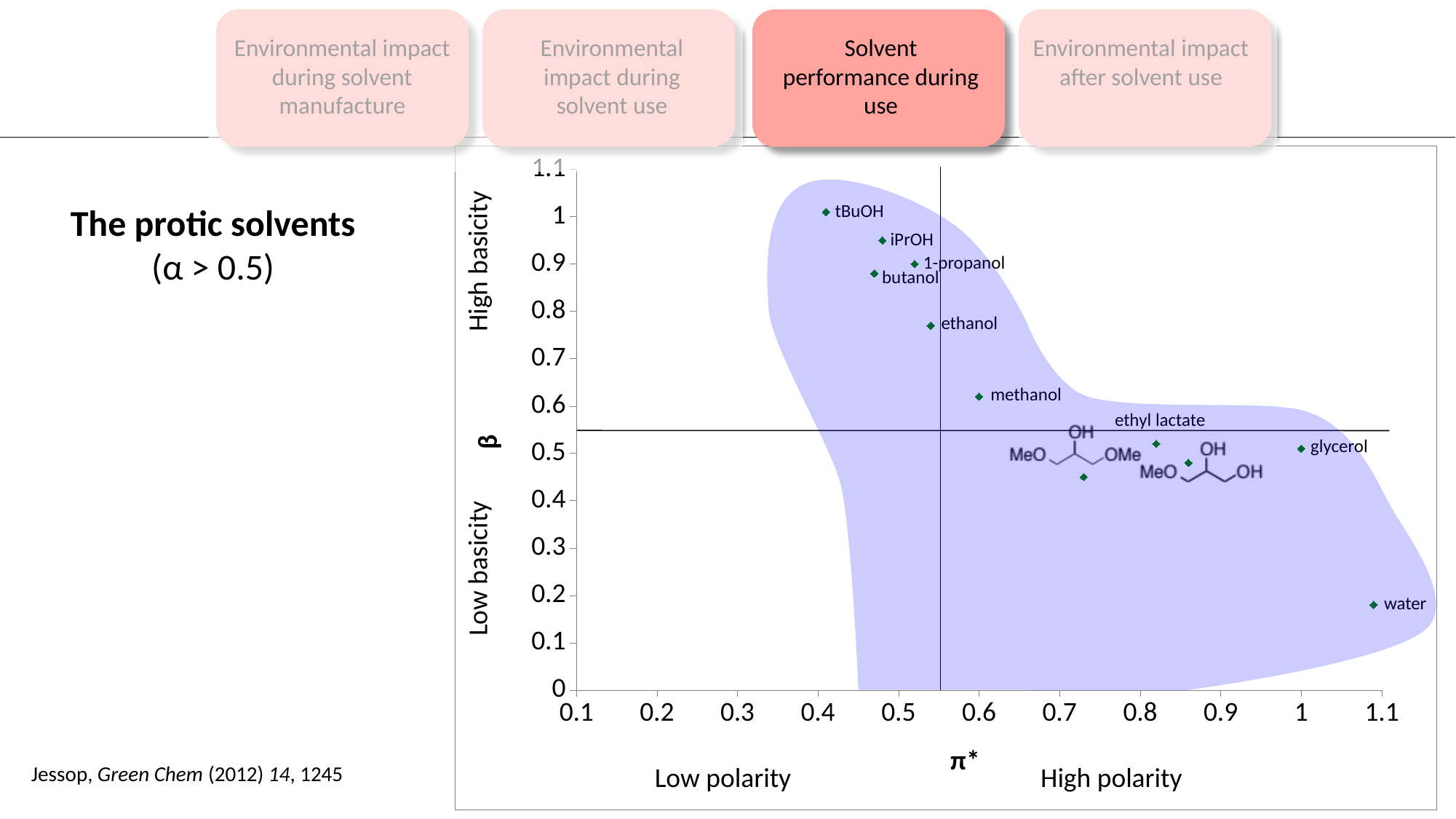
Which labeled solvent has the highest π* (polarity) value? water Which labeled solvent has the lowest β (basicity) value? water Which labeled solvent has the lowest π* (polarity) value? tBuOH What kind of chart is shown on the slide? scatter chart Is the β value for water greater or less than 0.3? less How many solvents are labeled by name on the chart? 9 Is the β value for methanol greater or less than 0.7? less Is the π* value for glycerol greater or less than 0.9? greater Which labeled solvent has the highest β (basicity) value? tBuOH Which has the higher β value, tBuOH or methanol? tBuOH What is the label on the x axis of the chart? π*